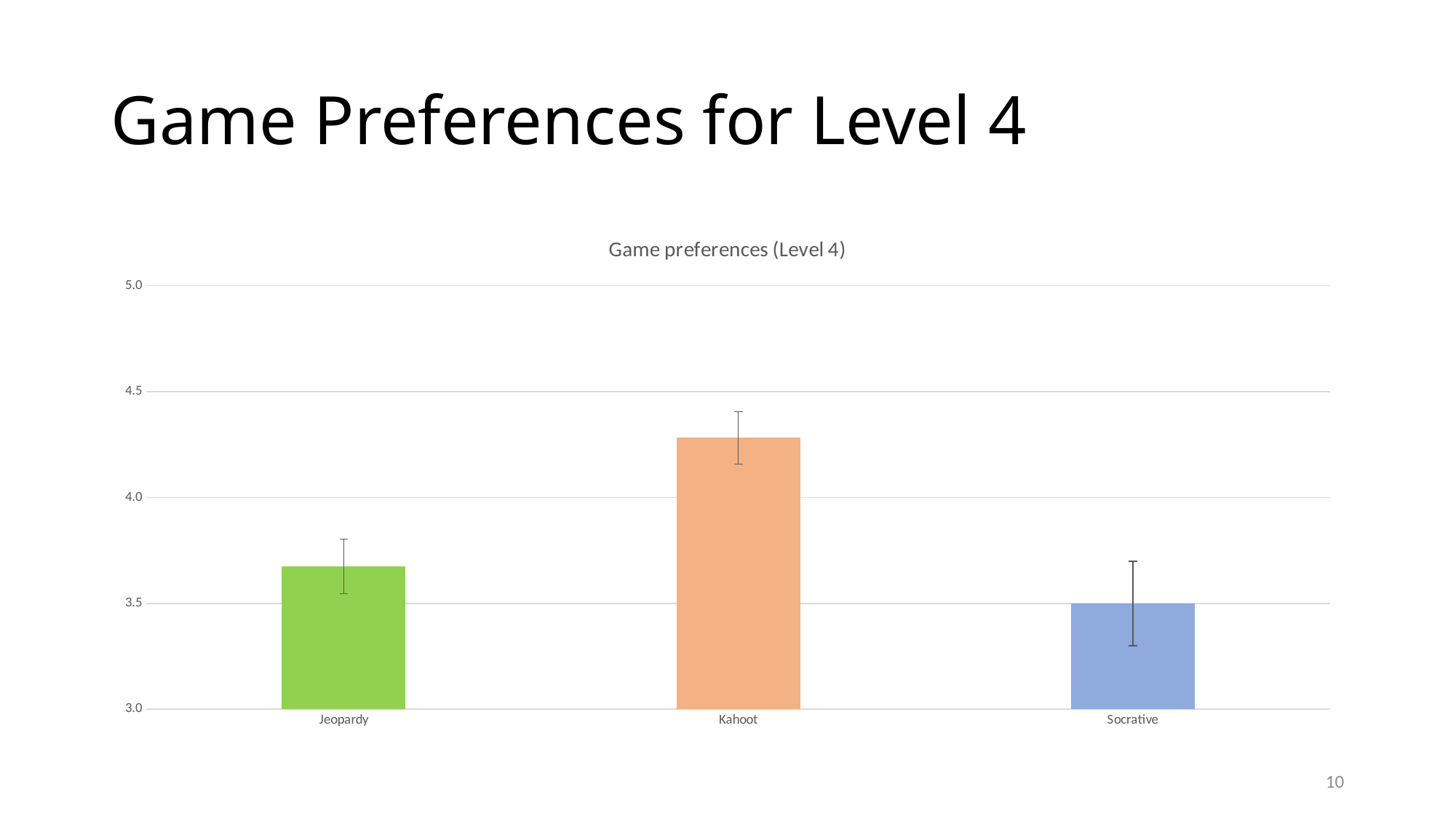
Which has a higher value, Kahoot or Jeopardy? Kahoot What colour is the bar for Kahoot? Orange What type of chart is shown on the slide? Bar chart Which game has the lowest bar in the chart? Socrative Which has a higher value, Jeopardy or Socrative? Jeopardy What is the title of the chart? Game preferences (Level 4) Is the value for Kahoot greater or less than 4.5? less Is the value for Jeopardy greater or less than 4.0? less Which game has the highest bar in the chart? Kahoot Is the value for Jeopardy greater or less than 3.5? greater How many games (categories) are shown on the x axis of the chart? 3